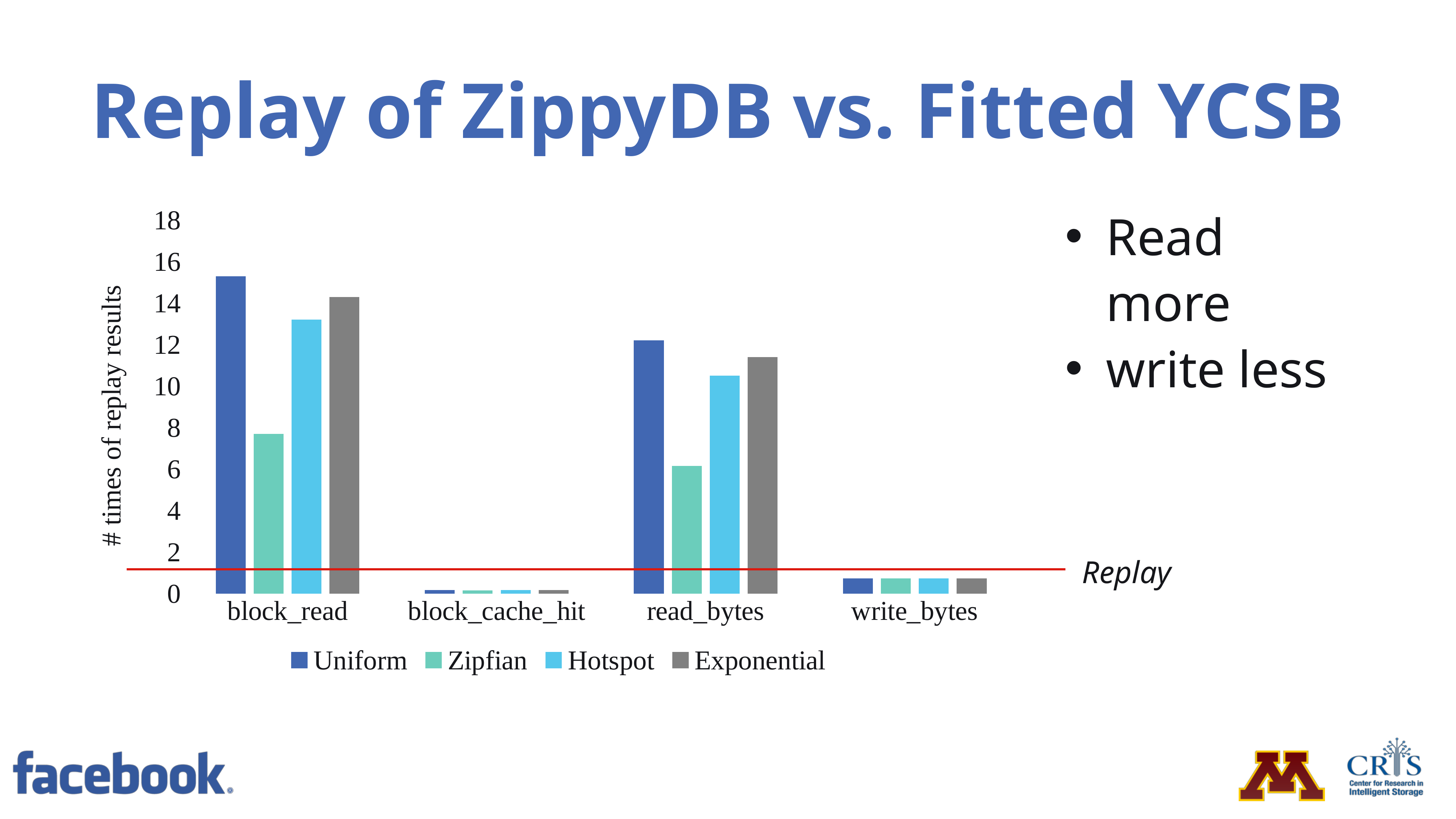
Which series has the lowest value for read_bytes? Zipfian What kind of chart is shown on the slide? bar chart Which series has the highest value for block_read? Uniform What label is written next to the red horizontal line on the chart? Replay How many categories are shown on the x axis of the chart? 4 Is the Zipfian value for read_bytes greater or less than 8? less Which is larger for read_bytes, the Exponential value or the Hotspot value? Exponential Which category has the tallest bars overall? block_read How many series does the chart's legend list? 4 Which series has the lowest value for block_read? Zipfian Is the Uniform value for block_read greater or less than 14? greater